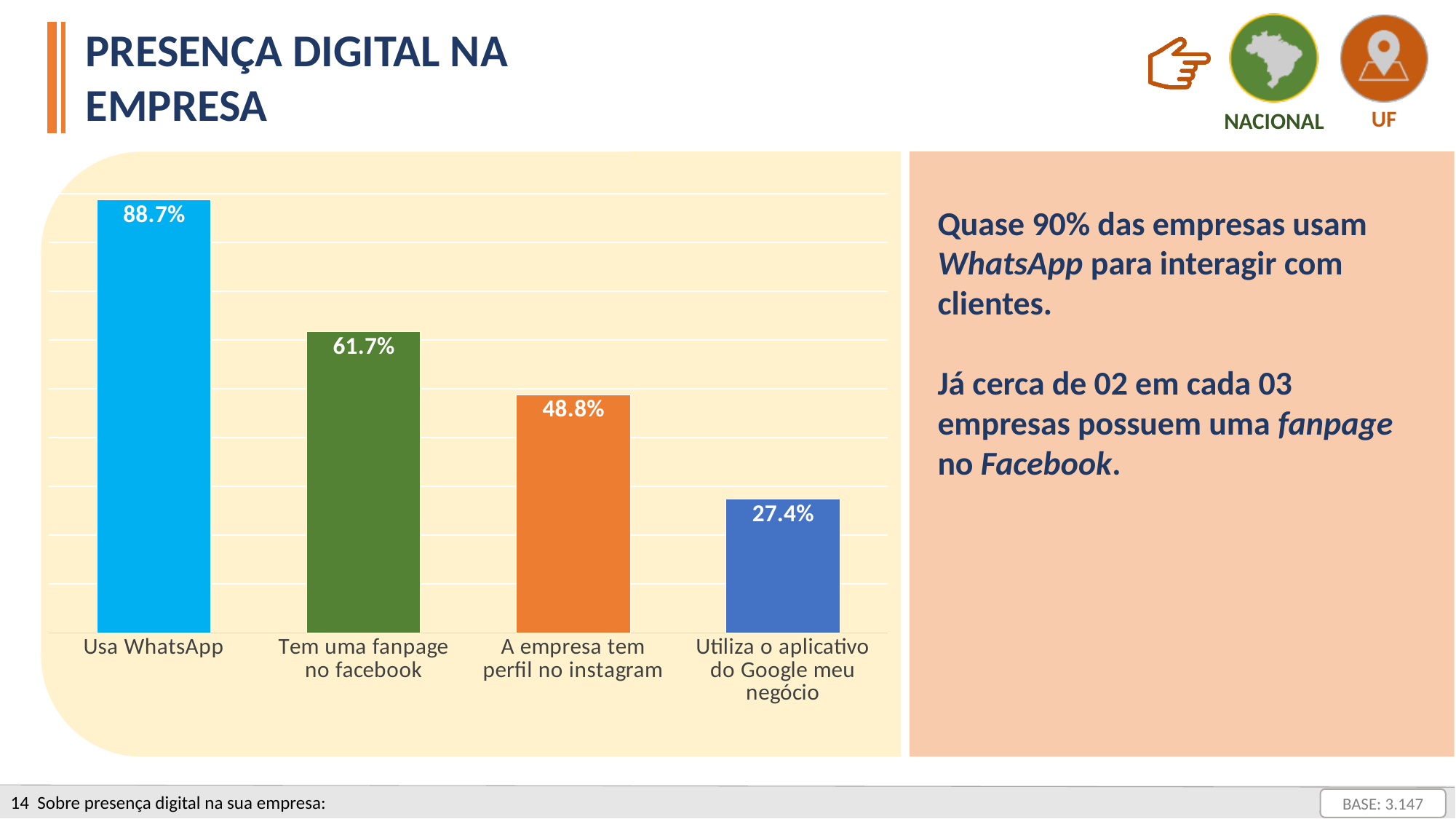
What is the difference between the values for 'Usa WhatsApp' and 'Tem uma fanpage no facebook'? 27.0% How many categories are shown in the chart? 4 What is the value for 'Tem uma fanpage no facebook'? 61.7% What is the value for 'A empresa tem perfil no instagram'? 48.8% What is the difference between the values for 'A empresa tem perfil no instagram' and 'Utiliza o aplicativo do Google meu negócio'? 21.4% What is the value for 'Usa WhatsApp'? 88.7% Do the values rise or fall from left to right across the categories? Fall What kind of chart is shown on the slide? Bar chart Which category has the highest value? Usa WhatsApp What is the value for 'Utiliza o aplicativo do Google meu negócio'? 27.4% Which is larger: the value for 'Tem uma fanpage no facebook' or the value for 'A empresa tem perfil no instagram'? Tem uma fanpage no facebook Which category has the lowest value? Utiliza o aplicativo do Google meu negócio